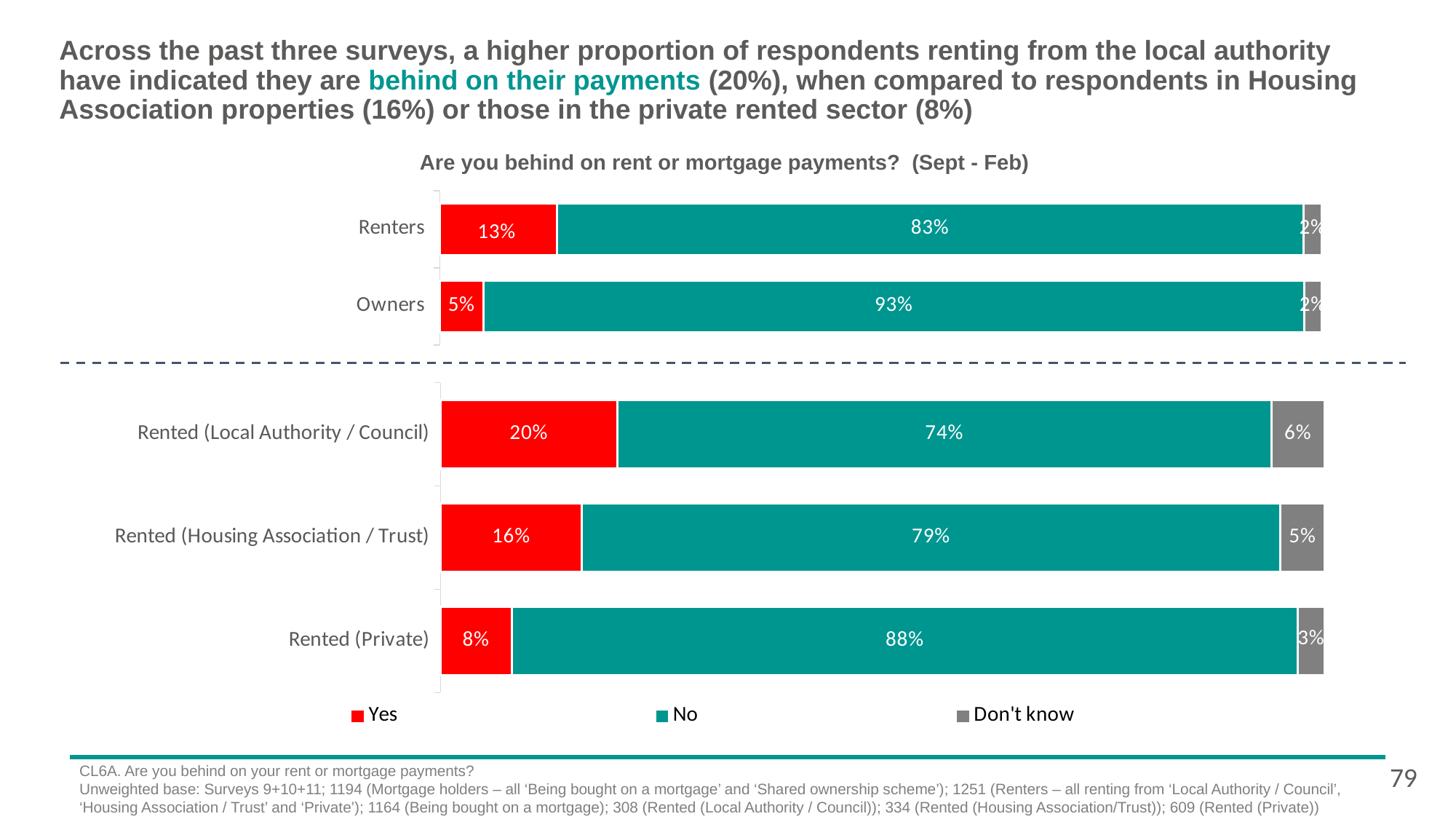
What percentage of Owners answered 'No'? 93% What percentage of respondents in Rented (Housing Association / Trust) answered 'Yes'? 16% How many categories are shown on the chart? 5 What kind of chart is shown on the slide? Stacked bar chart What percentage of Renters answered 'Yes' to being behind on rent or mortgage payments? 13% What is the difference between the 'Yes' percentage for Rented (Local Authority / Council) and Rented (Private)? 12% How many series does the legend list? 3 What is the 'Don't know' value for Rented (Local Authority / Council)? 6% What is the total of the stacked bar for Rented (Housing Association / Trust)? 100% Which category has the highest 'Yes' percentage? Rented (Local Authority / Council) Which category has the lowest 'Yes' percentage? Owners Which is larger: the 'No' percentage for Renters or for Rented (Private)? Rented (Private)